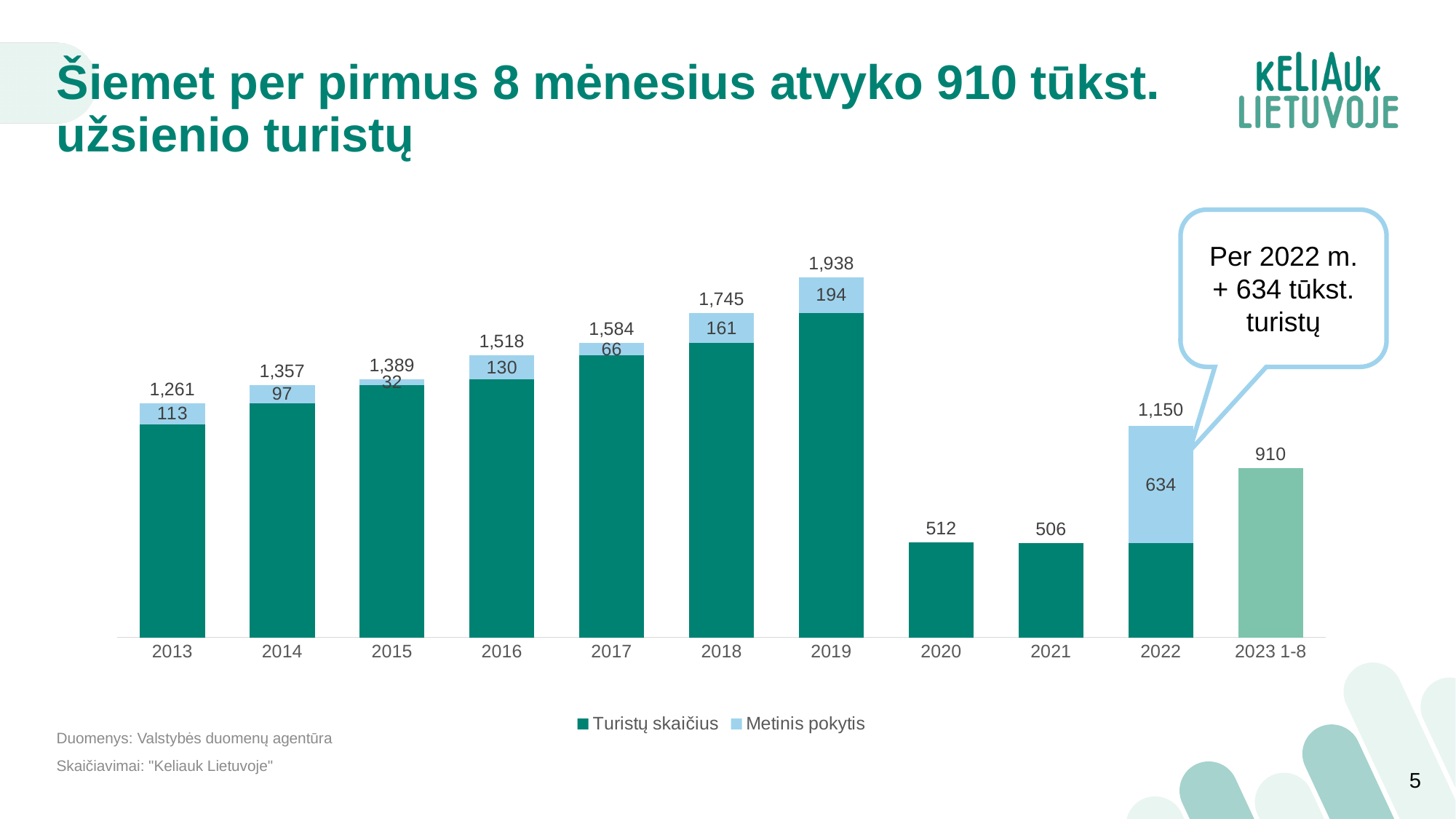
How many series does the legend list? 2 What kind of chart is shown on the slide? Bar chart Which year has the lowest total value in the chart? 2021 What is the 'Metinis pokytis' value shown inside the 2022 bar? 634 What is the 'Metinis pokytis' value shown for 2016? 130 What value is labelled for the 2023 1-8 bar? 910 What is the difference between the total values for 2019 and 2018? 193 What is the difference between the total values for 2020 and 2021? 6 How many categories (years) are shown on the x axis? 11 Which is larger, the total for 2022 or the value for 2023 1-8? 2022 Which year has the highest total value in the chart? 2019 What is the total value shown above the bar for 2019? 1,938